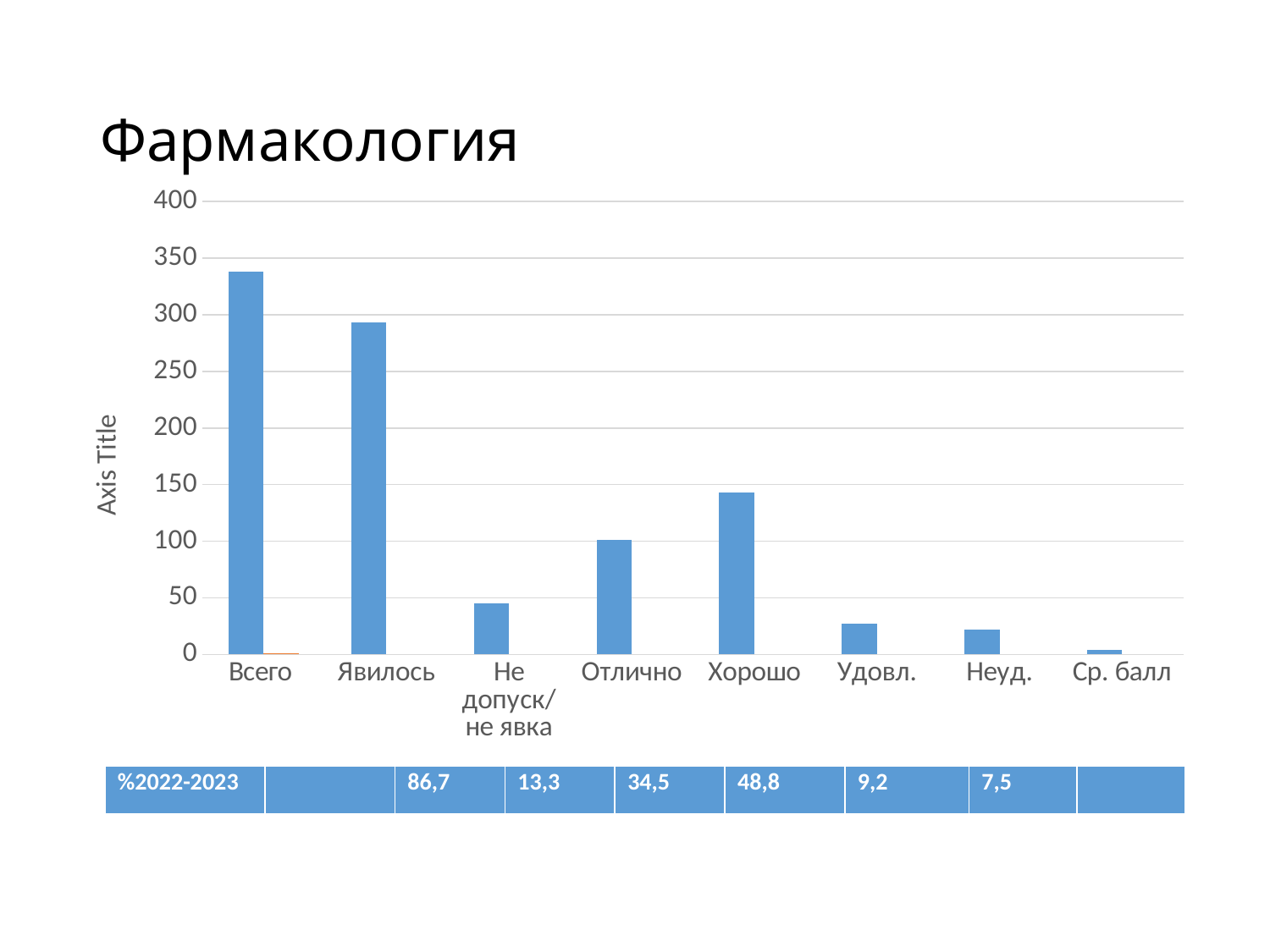
Is the value for Всего greater or less than 300? greater Is the value for Не допуск/не явка greater or less than 50? less Is the value for Хорошо greater or less than 150? less In the table row labelled %2022-2023 below the chart, what value is shown under Хорошо? 48,8 What type of chart is shown on the slide? bar chart Which bar is taller, Удовл. or Неуд.? Удовл. Which category has the tallest bar in the chart? Всего What is the title of the chart on the slide? Фармакология Which bar is taller, Хорошо or Отлично? Хорошо How many categories are shown on the x axis of the chart? 8